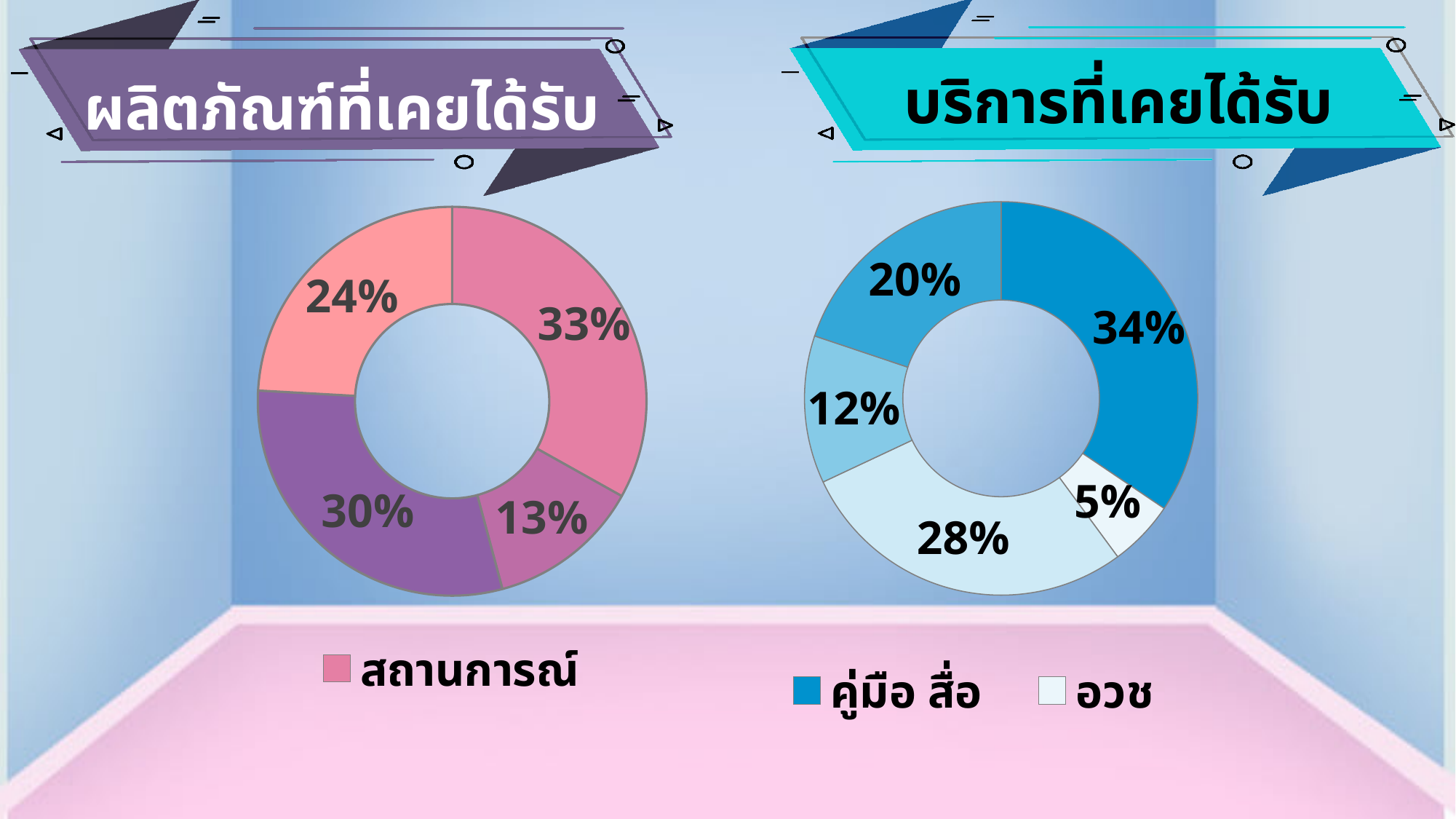
How many entries does the legend of the right chart "บริการที่เคยได้รับ" list? 2 How many slices does the left chart "ผลิตภัณฑ์ที่เคยได้รับ" have? 4 How many slices does the right chart "บริการที่เคยได้รับ" have? 5 In the left chart "ผลิตภัณฑ์ที่เคยได้รับ", what share does the "สถานการณ์" slice have? 33% In the left chart "ผลิตภัณฑ์ที่เคยได้รับ", what is the smallest slice's value? 13% In the left chart "ผลิตภัณฑ์ที่เคยได้รับ", what is the largest slice's value? 33% In the right chart "บริการที่เคยได้รับ", which is larger: "คู่มือ สื่อ" or "อวช"? คู่มือ สื่อ In the right chart "บริการที่เคยได้รับ", what is the smallest slice's value? 5% What kind of chart is the left chart titled "ผลิตภัณฑ์ที่เคยได้รับ"? Pie (donut) chart In the right chart "บริการที่เคยได้รับ", what share does "อวช" have? 5% In the left chart "ผลิตภัณฑ์ที่เคยได้รับ", what is the difference between the 30% slice and the 24% slice? 6% In the right chart "บริการที่เคยได้รับ", what share does "คู่มือ สื่อ" have? 34%